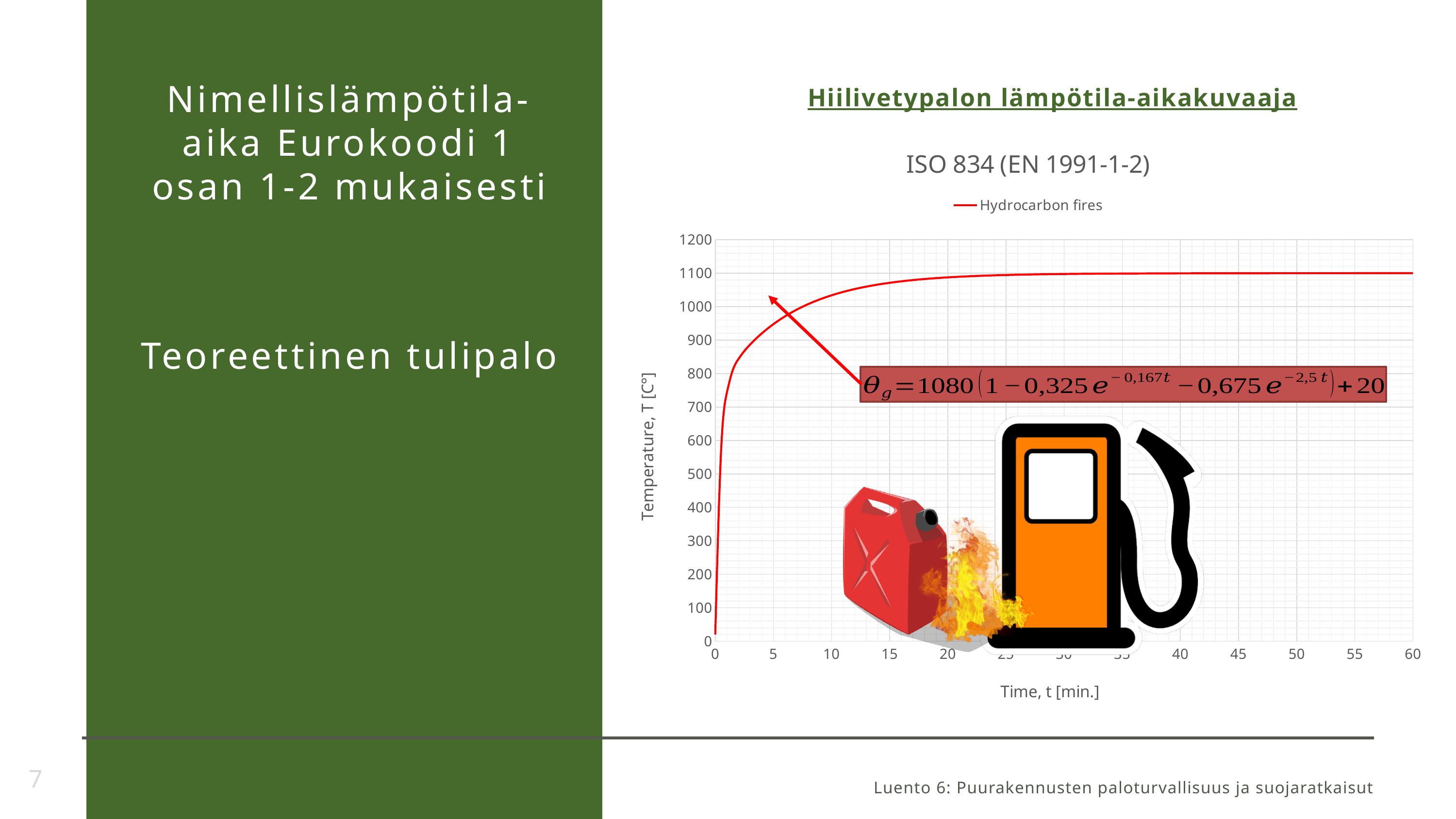
What kind of chart is shown under the heading 'ISO 834 (EN 1991-1-2)'? line chart Is the temperature of the Hydrocarbon fires curve at 0 minutes greater or less than 100? less What is the title printed above the legend of the temperature-time chart? ISO 834 (EN 1991-1-2) Which is larger on the Hydrocarbon fires curve: the temperature at 2 minutes or at 30 minutes? 30 minutes Is the temperature of the Hydrocarbon fires curve at 5 minutes greater or less than 800? greater Is the temperature of the Hydrocarbon fires curve at 60 minutes greater or less than 1000? greater How many series does the legend of the ISO 834 chart list? 1 What is the name of the series shown in the legend of the ISO 834 chart? Hydrocarbon fires Does the Hydrocarbon fires curve rise or fall as time increases along the x axis? rise